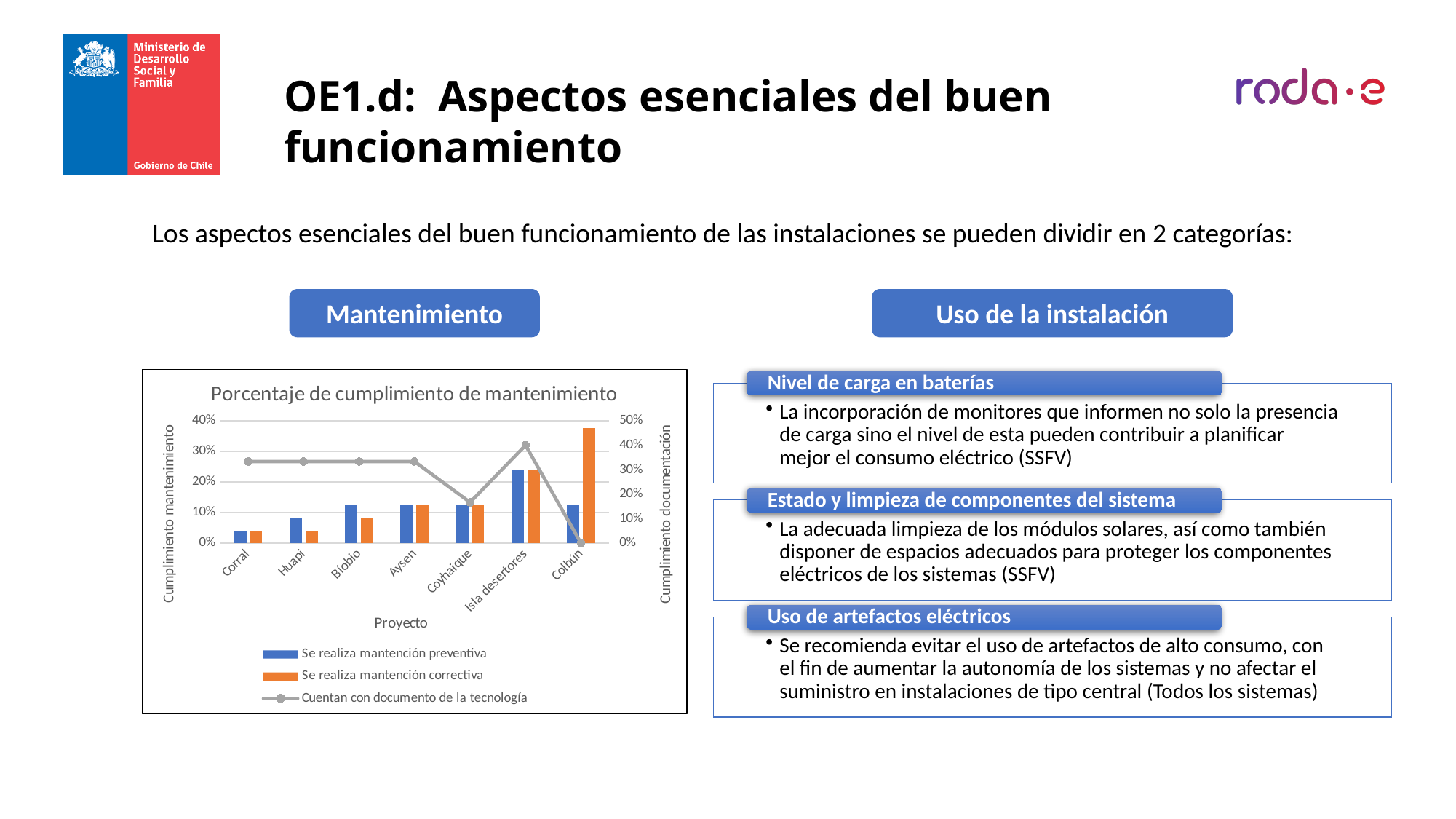
How many projects (categories) are shown on the x axis of the chart? 7 How many series does the chart legend list? 3 Which project has the lowest value for 'Cuentan con documento de la tecnología'? Colbún Is the value for 'Se realiza mantención preventiva' at Corral greater or less than 10%? less What is the value of 'Cuentan con documento de la tecnología' for Colbún? 0% At Huapi, which is larger: 'Se realiza mantención preventiva' or 'Se realiza mantención correctiva'? Se realiza mantención preventiva Which project has the highest value for 'Se realiza mantención preventiva'? Isla desertores Which project has the highest value for 'Se realiza mantención correctiva'? Colbún At Colbún, which is larger: 'Se realiza mantención preventiva' or 'Se realiza mantención correctiva'? Se realiza mantención correctiva Is the value for 'Se realiza mantención correctiva' at Colbún greater or less than 30%? greater What is the title of the chart on the slide? Porcentaje de cumplimiento de mantenimiento What kind of chart is shown on the slide? Combined bar and line chart